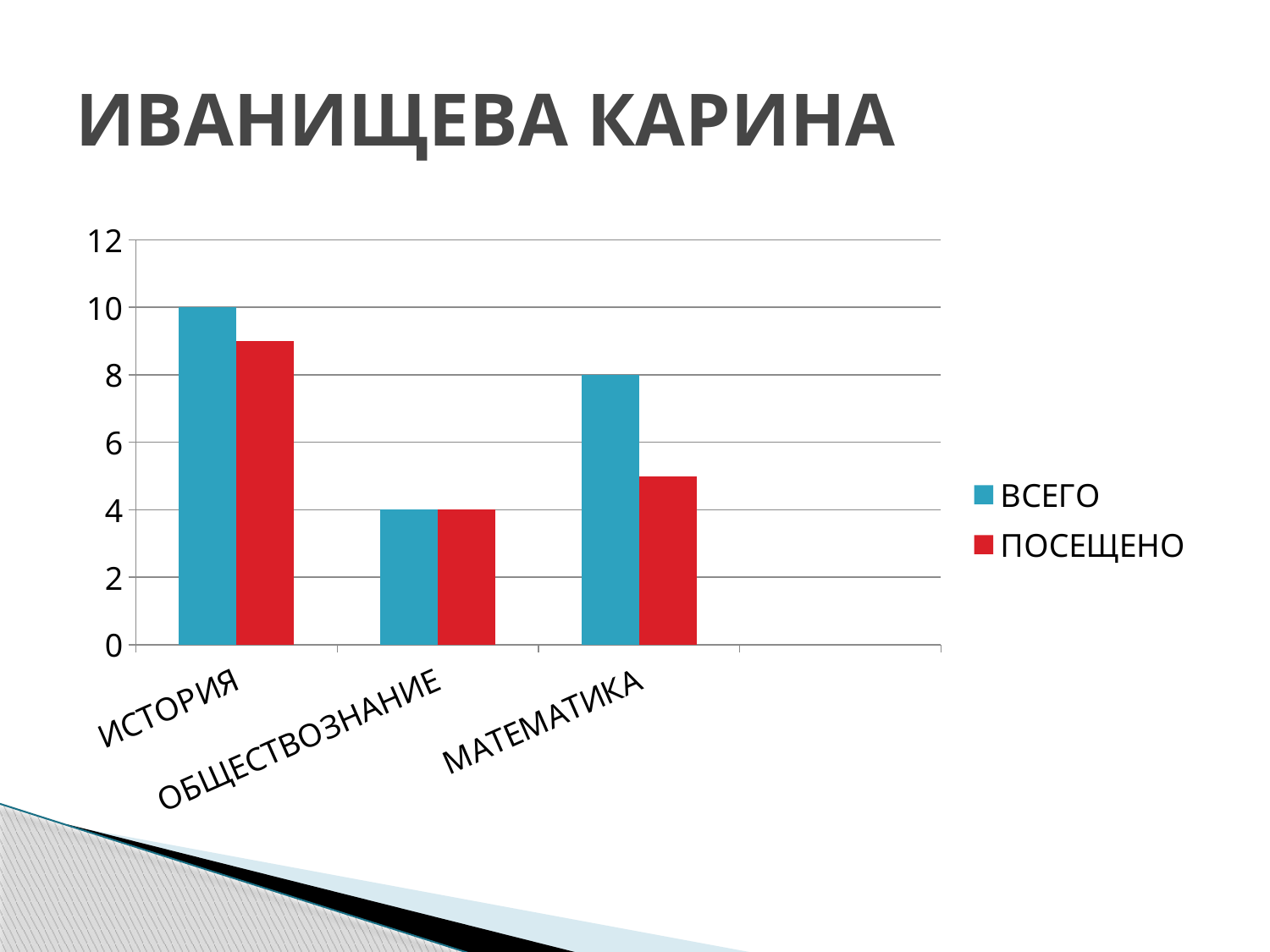
Is the ПОСЕЩЕНО value for ИСТОРИЯ greater or less than 8? greater What is the ВСЕГО value for МАТЕМАТИКА? 8 Which category has the highest ВСЕГО value? ИСТОРИЯ What is the difference between the ВСЕГО values for ИСТОРИЯ and МАТЕМАТИКА? 2 Is the ПОСЕЩЕНО value for МАТЕМАТИКА greater or less than 6? less How many series does the chart legend list? 2 Which series is shown in red in the chart? ПОСЕЩЕНО What type of chart is shown on the slide? Bar chart What is the ВСЕГО value for ИСТОРИЯ? 10 What is the ПОСЕЩЕНО value for ОБЩЕСТВОЗНАНИЕ? 4 Which category has the lowest ВСЕГО value? ОБЩЕСТВОЗНАНИЕ How many categories are shown on the x axis of the chart? 3